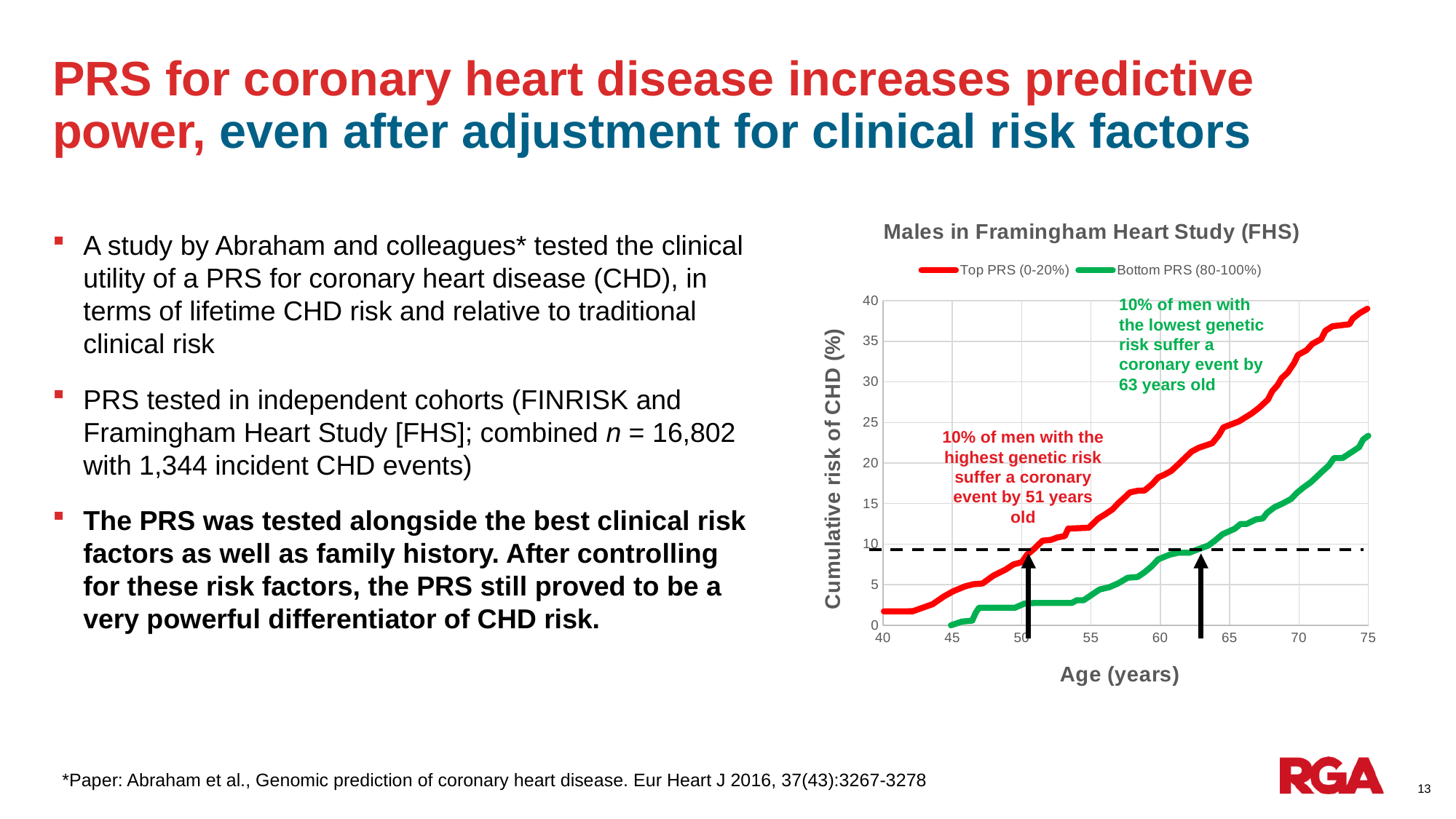
Which series is drawn in red in the chart? Top PRS (0-20%) At age 75, which series has the higher cumulative risk of CHD: Top PRS (0-20%) or Bottom PRS (80-100%)? Top PRS (0-20%) How many series does the legend of the chart list? 2 What is the title of the chart? Males in Framingham Heart Study (FHS) Is the cumulative risk of CHD for Top PRS (0-20%) at age 60 greater or less than 15? greater Does the cumulative risk of CHD for the Top PRS (0-20%) series rise or fall as age increases? Rise Is the cumulative risk of CHD for Bottom PRS (80-100%) at age 75 greater or less than 20? greater Is the cumulative risk of CHD for Bottom PRS (80-100%) at age 55 greater or less than 5? less According to the chart annotation, by what age do 10% of men with the lowest genetic risk suffer a coronary event? 63 years old What kind of chart is shown on the slide? Line chart According to the chart annotation, by what age do 10% of men with the highest genetic risk suffer a coronary event? 51 years old